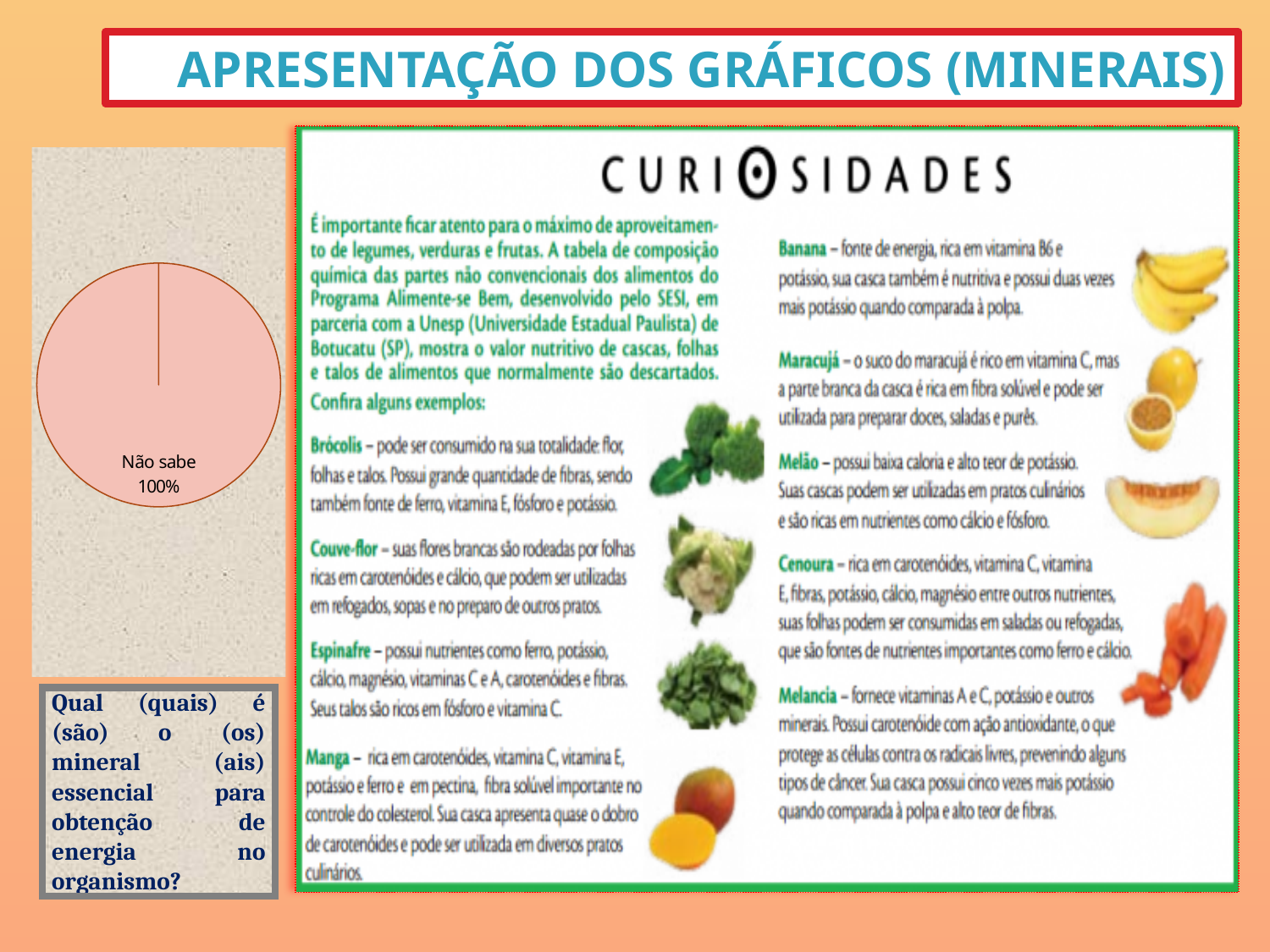
Which category is the largest in the pie chart? Não sabe What kind of chart is shown on the left of the slide? pie chart Is the value for "Não sabe" in the pie chart greater or less than 50%? greater What is the value shown for the "Não sabe" slice in the pie chart? 100% How many categories are shown in the pie chart? 1 What is the label of the only slice in the pie chart? Não sabe What share of the pie chart does the "Não sabe" slice take up? 100%